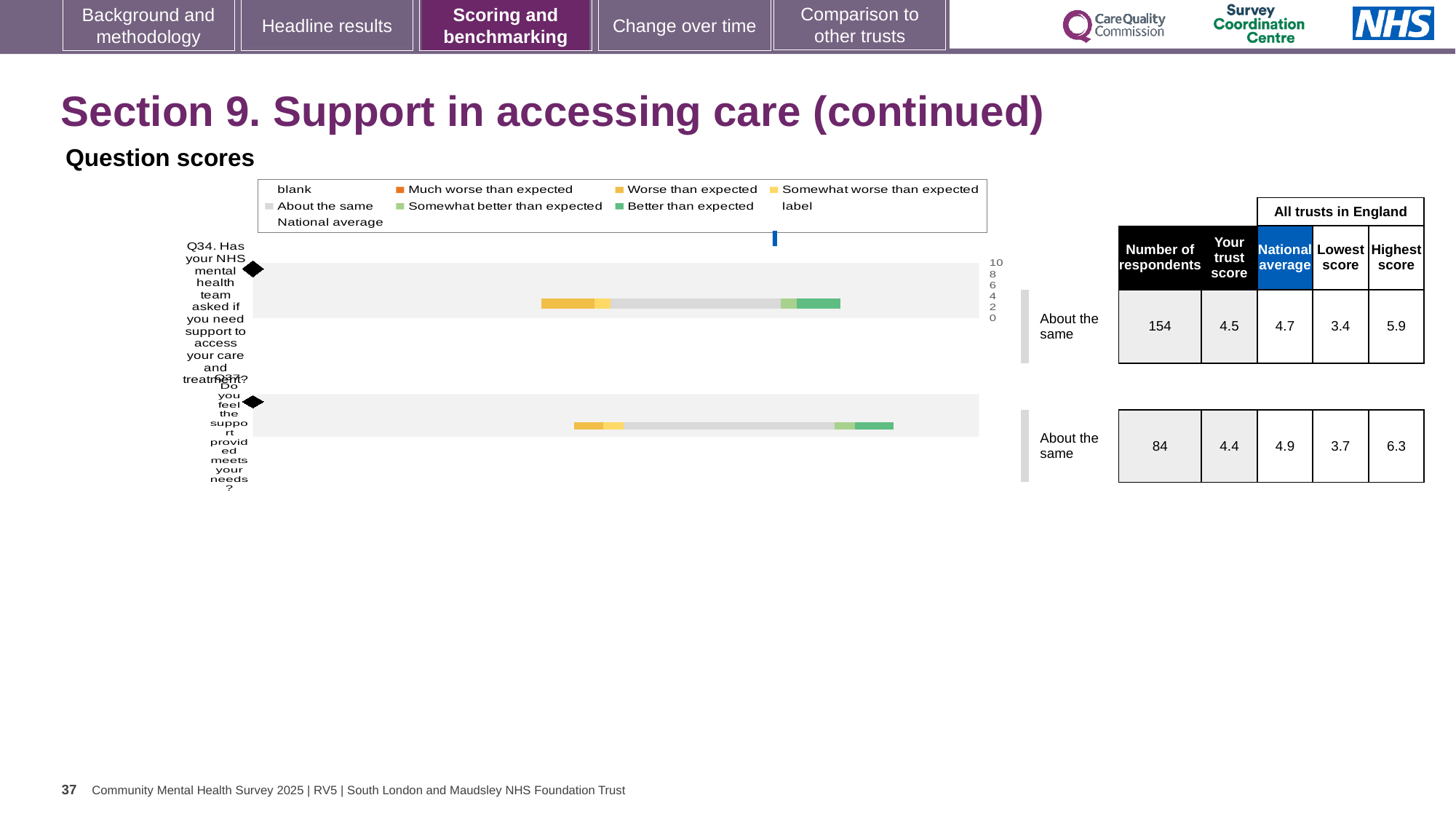
In the chart legend, what does the dark blue marker represent? National average What kind of chart is used to show the question scores on this slide? bar chart How many respondents are listed for Q34 (Has your NHS mental health team asked if you need support to access your care and treatment?)? 154 What is the difference between the highest score and the lowest score for Q37? 2.6 For Q34, which is larger: the trust score or the national average? National average How many questions are plotted in the question scores chart? 2 What is the trust score for Q34? 4.5 What is the highest score among all trusts in England for Q34? 5.9 Which question has the larger number of respondents, Q34 or Q37? Q34 In the chart legend, what colour represents 'Better than expected'? green What is the national average for Q37 (Do you feel the support provided meets your needs?)? 4.9 What is the lowest score among all trusts in England for Q37? 3.7